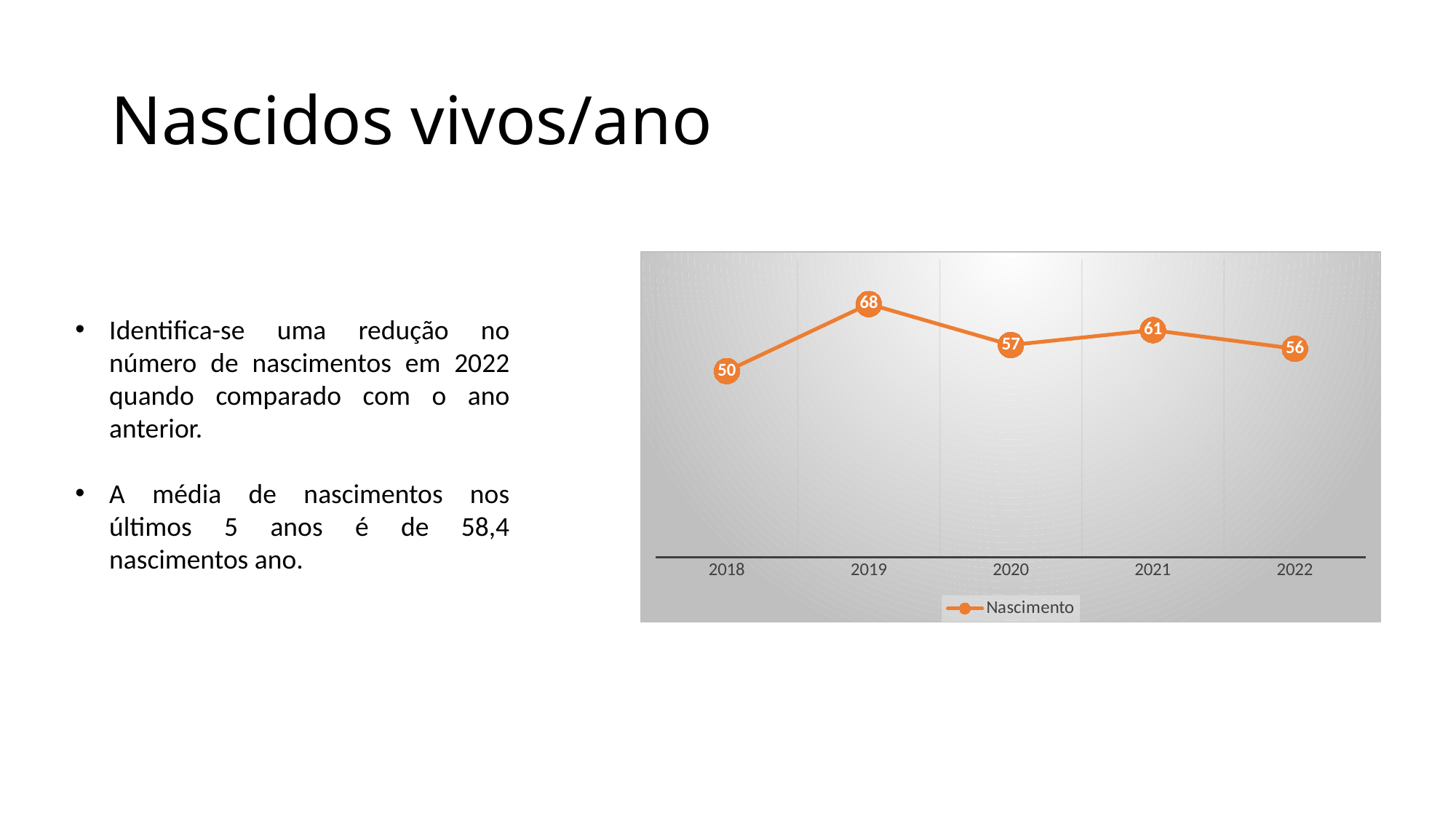
Which is larger, the value for 2020 or the value for 2021? 2021 Which year has the highest value? 2019 What kind of chart is shown? line chart Which year has the lowest value? 2018 What is the value for 2018? 50 What is the value for 2019? 68 What is the value for 2020? 57 What is the difference between the values for 2021 and 2022? 5 What is the difference between the values for 2019 and 2018? 18 How many years are plotted on the chart? 5 What is the value for 2022? 56 What series name does the legend show? Nascimento